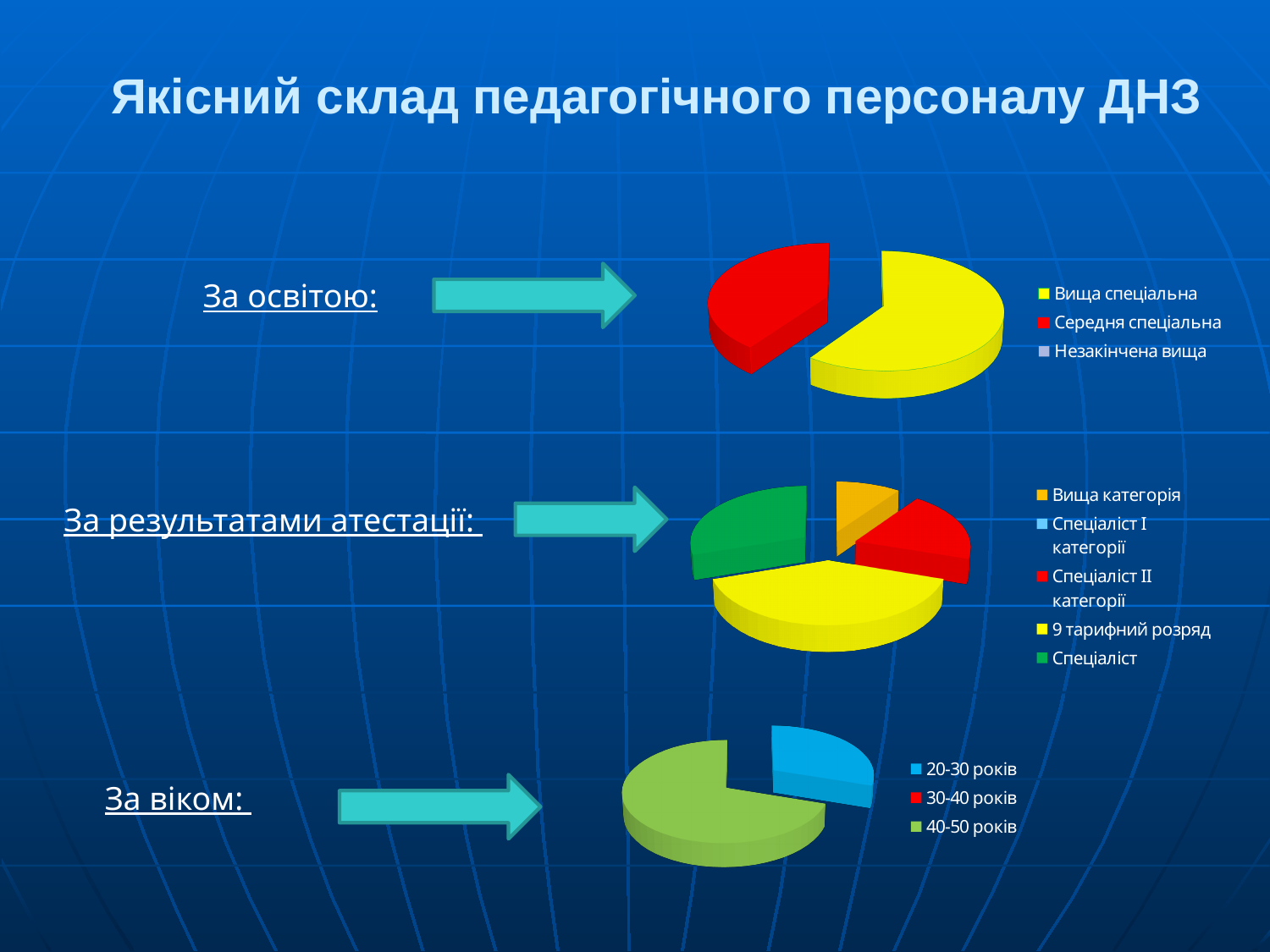
In the 'За освітою' chart, which slice is larger: 'Вища спеціальна' or 'Середня спеціальна'? Вища спеціальна How many entries does the legend of the 'За освітою' chart list? 3 How many entries does the legend of the 'За результатами атестації' chart list? 5 In the 'За віком' chart, which category has the largest slice? 40-50 років In the 'За результатами атестації' chart, which slice is larger: 'Спеціаліст II категорії' or 'Вища категорія'? Спеціаліст II категорії In the 'За результатами атестації' chart, which slice is larger: 'Спеціаліст' or 'Вища категорія'? Спеціаліст In the 'За освітою' chart, which category has the largest slice? Вища спеціальна What colour is the '9 тарифний розряд' slice in the 'За результатами атестації' chart? yellow How many entries does the legend of the 'За віком' chart list? 3 In the 'За результатами атестації' chart, which category has the largest slice? 9 тарифний розряд What kind of chart is used for the 'За освітою' chart? pie chart